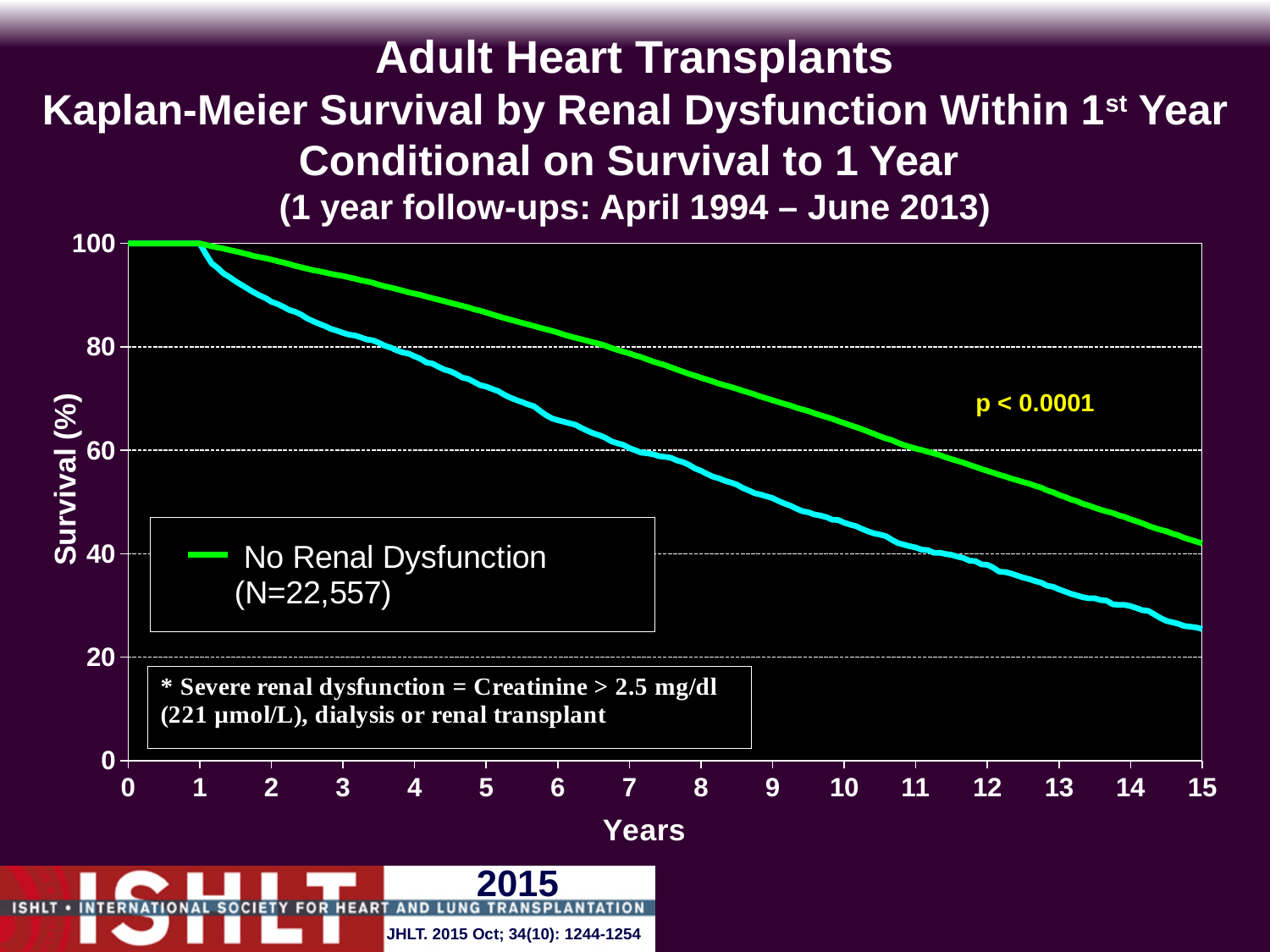
How many series does the legend list? 1 At 10 years, which line shows higher survival, the green line or the cyan line? green line Does survival for the No Renal Dysfunction group rise or fall as years increase? fall Is the survival for No Renal Dysfunction at 10 years greater or less than 60? greater Is the survival shown by the cyan line at 15 years greater or less than 40? less Is the survival for No Renal Dysfunction at 15 years greater or less than 60? less How many survival curves are plotted on the chart? 2 What is the N for the No Renal Dysfunction group shown in the legend? N=22,557 What p-value is printed on the chart? p < 0.0001 What kind of chart is shown on the slide? line chart